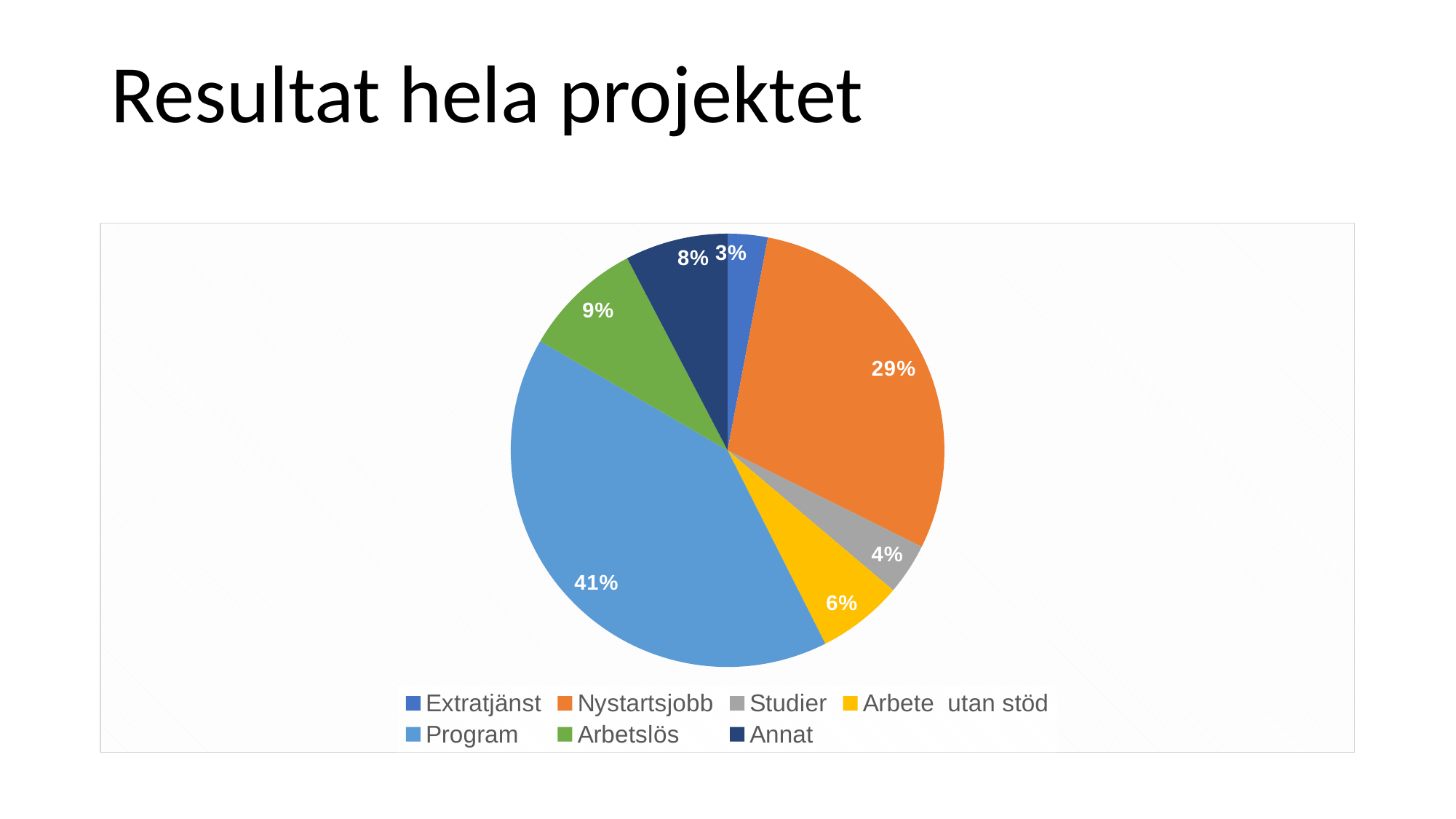
Which category has the largest slice of the pie? Program What is the value shown for Annat? 8% What is the value shown for Arbete utan stöd? 6% What is the value shown for Studier? 4% Which category has the smallest slice of the pie? Extratjänst How many categories does the pie chart have? 7 What share of the pie does Nystartsjobb represent? 29% What type of chart is shown on the slide? Pie chart What share of the pie does Program represent? 41% Which is larger, the share for Arbetslös or the share for Annat? Arbetslös What is the difference between the shares for Program and Nystartsjobb? 12% What is the value shown for Arbetslös? 9%